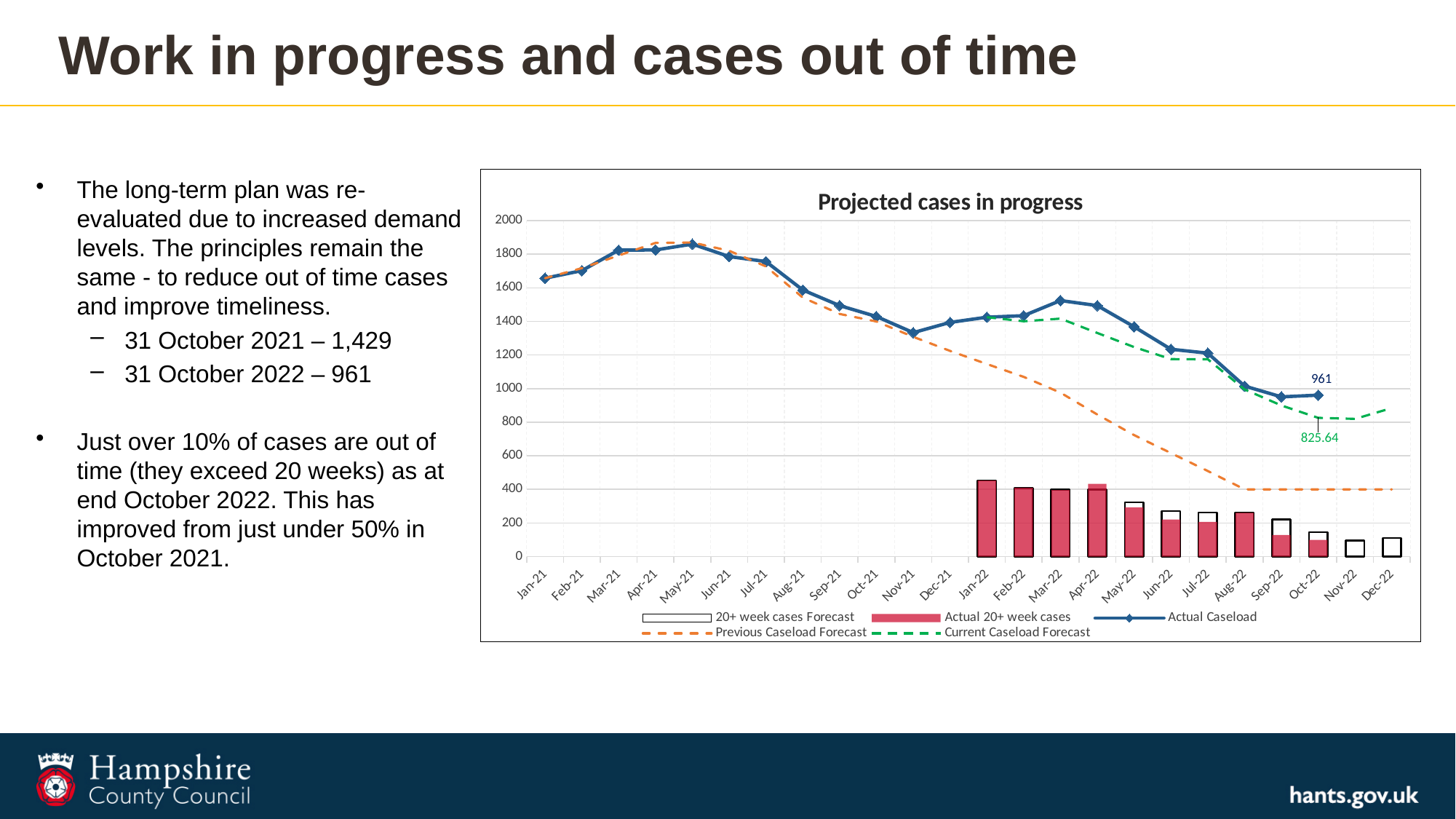
Is the Previous Caseload Forecast value for Dec-22 greater or less than 600? less What value is printed as a data label on the Current Caseload Forecast line? 825.64 What is the title of the chart? Projected cases in progress Does the Actual Caseload line rise or fall between May-21 and Nov-21? fall In which month does the Actual Caseload line reach its highest point? May-21 How many series does the chart legend list? 5 Is the Actual Caseload value for Jan-21 greater or less than 1600? greater Which is larger, the Actual Caseload for Mar-22 or for Aug-22? Mar-22 How many months are shown along the x axis of the chart? 24 What is the labelled Actual Caseload value for Oct-22? 961 Is the Actual 20+ week cases bar for Jan-22 greater or less than 400? greater What kind of chart is shown on the slide? A combined line and bar chart